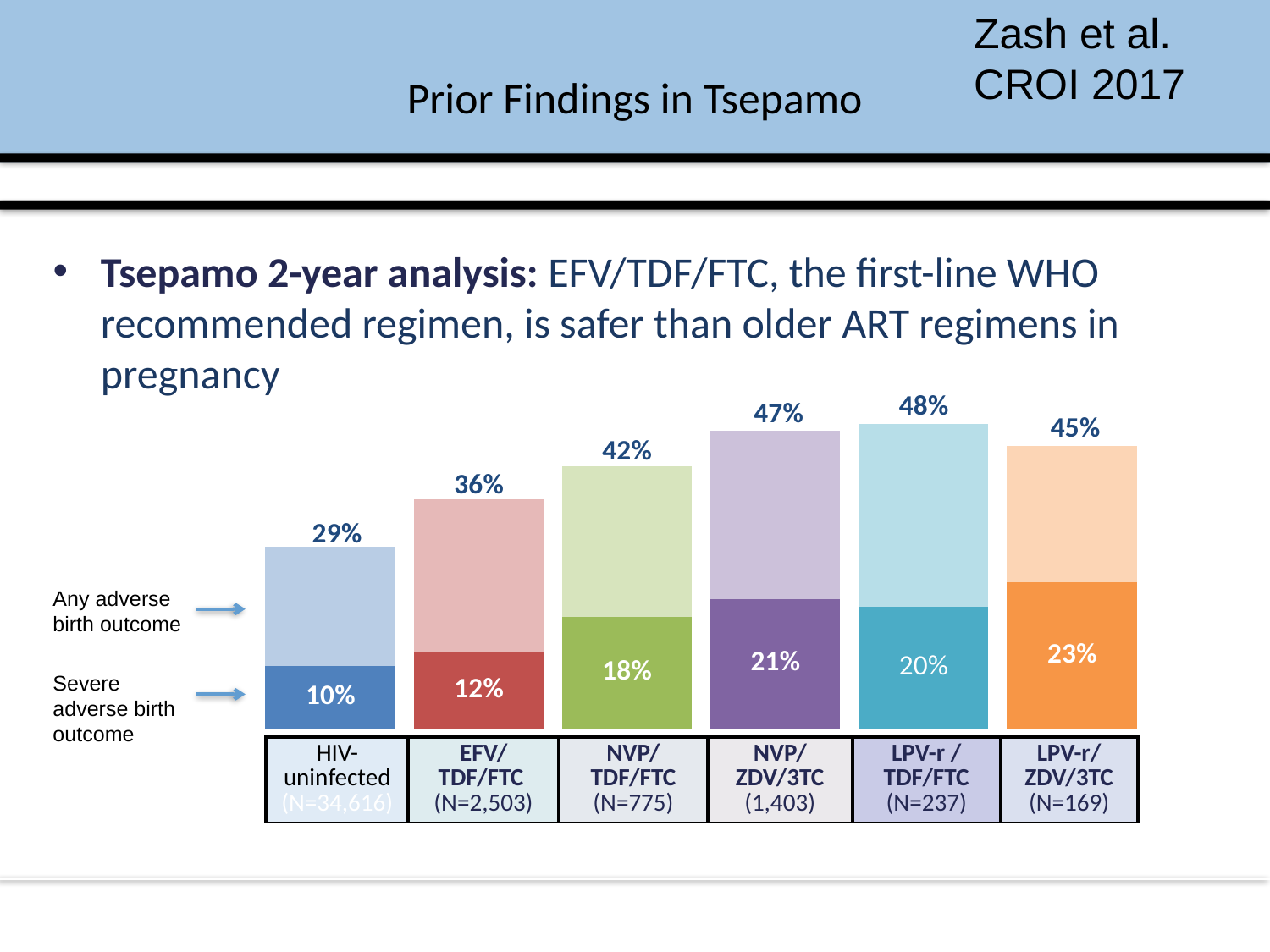
What is the percentage of any adverse birth outcome for the HIV-uninfected group? 29% What is the difference in any adverse birth outcome percentage between the EFV/TDF/FTC group and the HIV-uninfected group? 7% What is the difference between the any adverse birth outcome percentage and the severe adverse birth outcome percentage for the NVP/TDF/FTC group? 24% Which group has the highest percentage of any adverse birth outcome? LPV-r / TDF/FTC How many groups are shown on the x axis of the chart? 6 What is the sample size (N) shown for the EFV/TDF/FTC group? N=2,503 Which group has the lowest percentage of severe adverse birth outcome? HIV-uninfected Which group has a higher percentage of severe adverse birth outcome, EFV/TDF/FTC or NVP/TDF/FTC? NVP/TDF/FTC What is the percentage of any adverse birth outcome for the EFV/TDF/FTC group? 36% What type of chart is shown on the slide? Bar chart What is the percentage of severe adverse birth outcome for the NVP/ZDV/3TC group? 21% What is the percentage of severe adverse birth outcome for the LPV-r/ZDV/3TC group? 23%